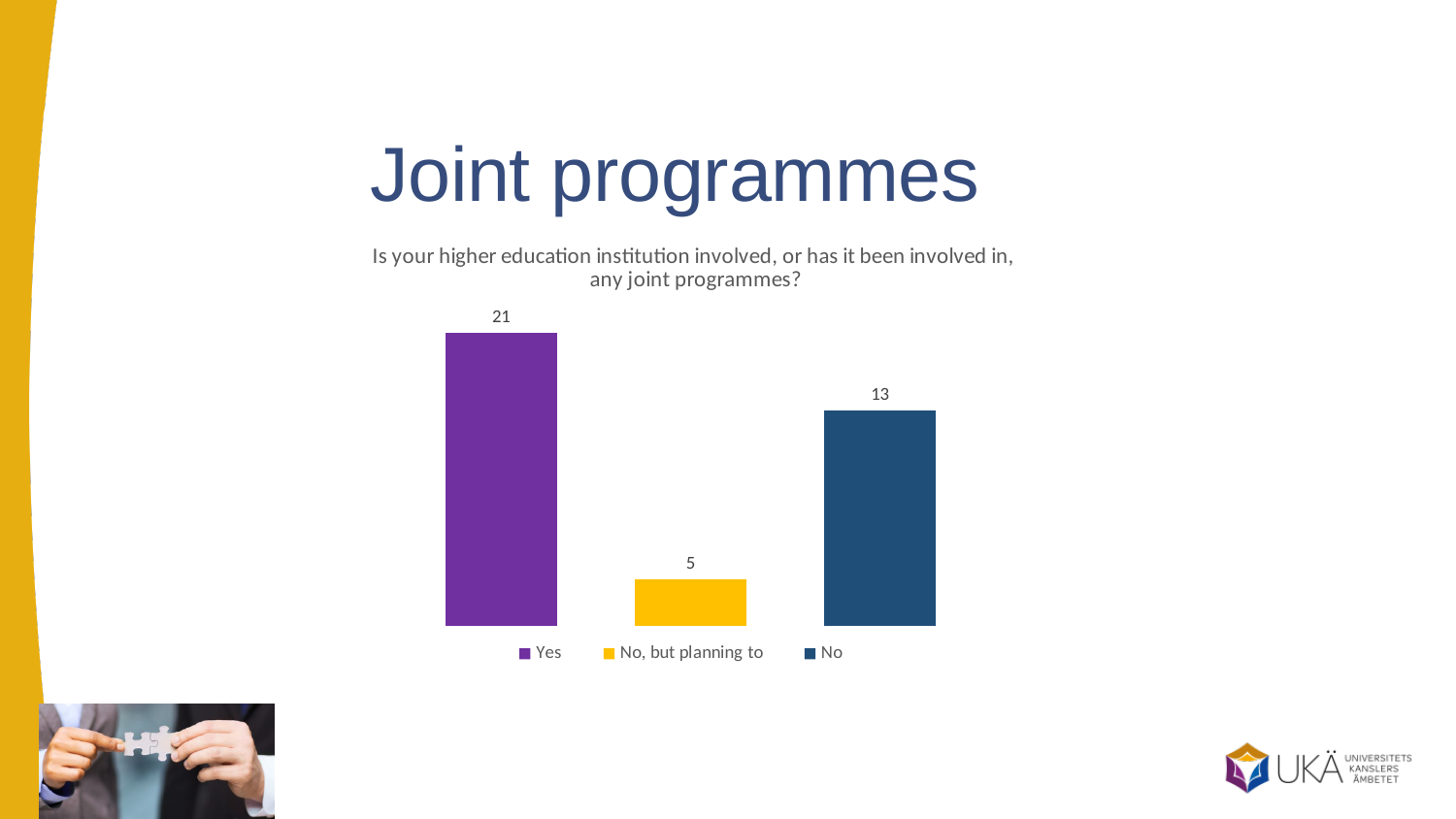
Which category has the lowest value? No, but planning to What is the value for "No"? 13 Which category has the highest value? Yes How many categories are shown in the chart? 3 What kind of chart is shown on the slide? Bar chart How many entries does the legend list? 3 What is the value for "Yes"? 21 Which is larger, the value for "Yes" or the value for "No"? Yes What is the value for "No, but planning to"? 5 What is the difference between the values for "Yes" and "No"? 8 What is the title of the chart? Is your higher education institution involved, or has it been involved in, any joint programmes? What is the difference between the values for "No" and "No, but planning to"? 8